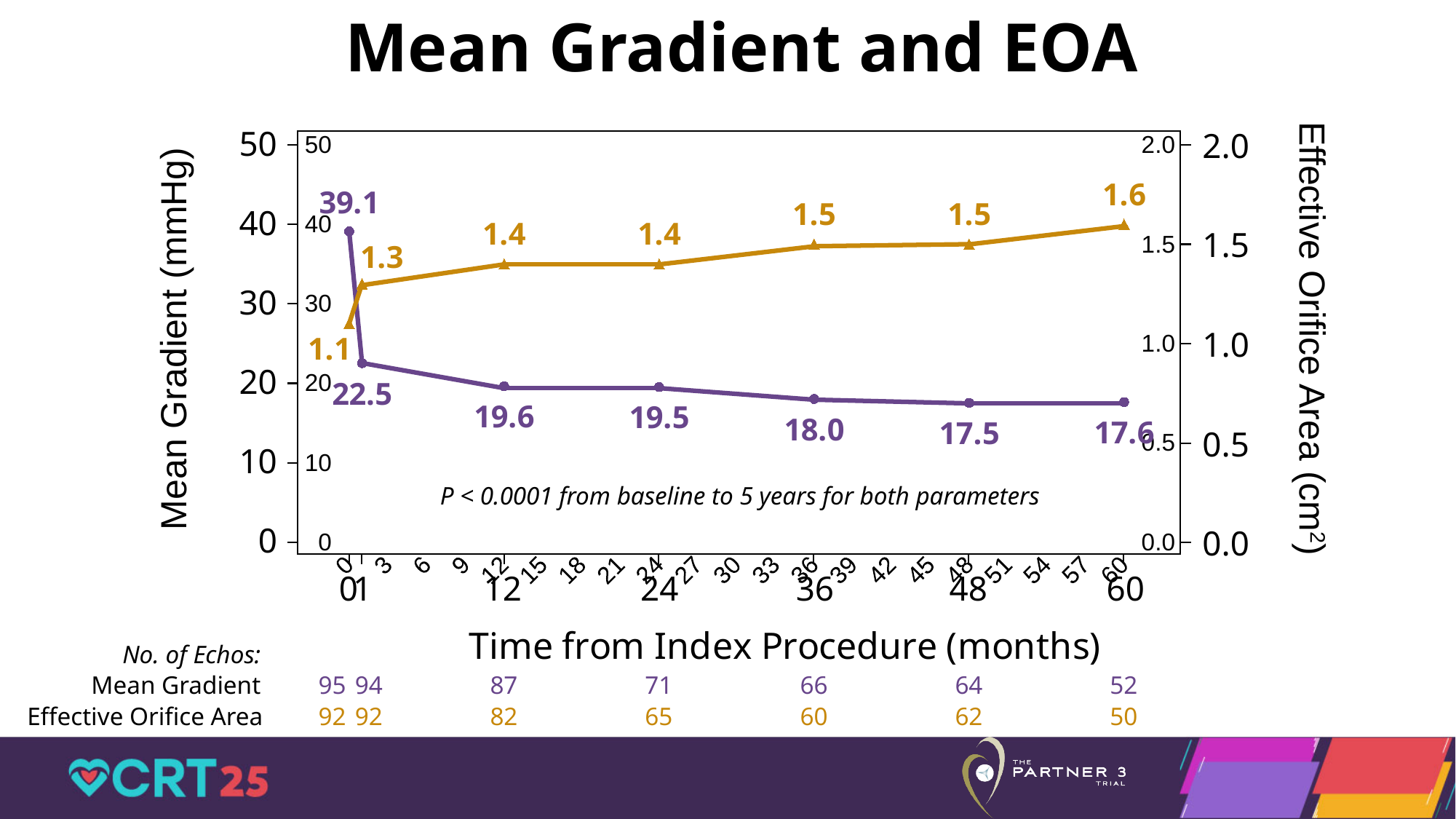
Does the mean gradient rise or fall from baseline to 60 months? fall What is the label of the right-hand y axis? Effective Orifice Area (cm²) At which time point is the effective orifice area lowest? 0 months (baseline) What is the mean gradient at 36 months? 18.0 What type of chart is shown on the slide? line chart Is the mean gradient at 12 months greater or less than the mean gradient at 1 month? less At which time point is the mean gradient highest? 0 months (baseline) What is the mean gradient at baseline (0 months)? 39.1 What is the effective orifice area at baseline (0 months)? 1.1 What is the difference between the mean gradient at baseline and at 60 months? 21.5 How many time points are plotted for each series? 7 What is the effective orifice area at 60 months? 1.6